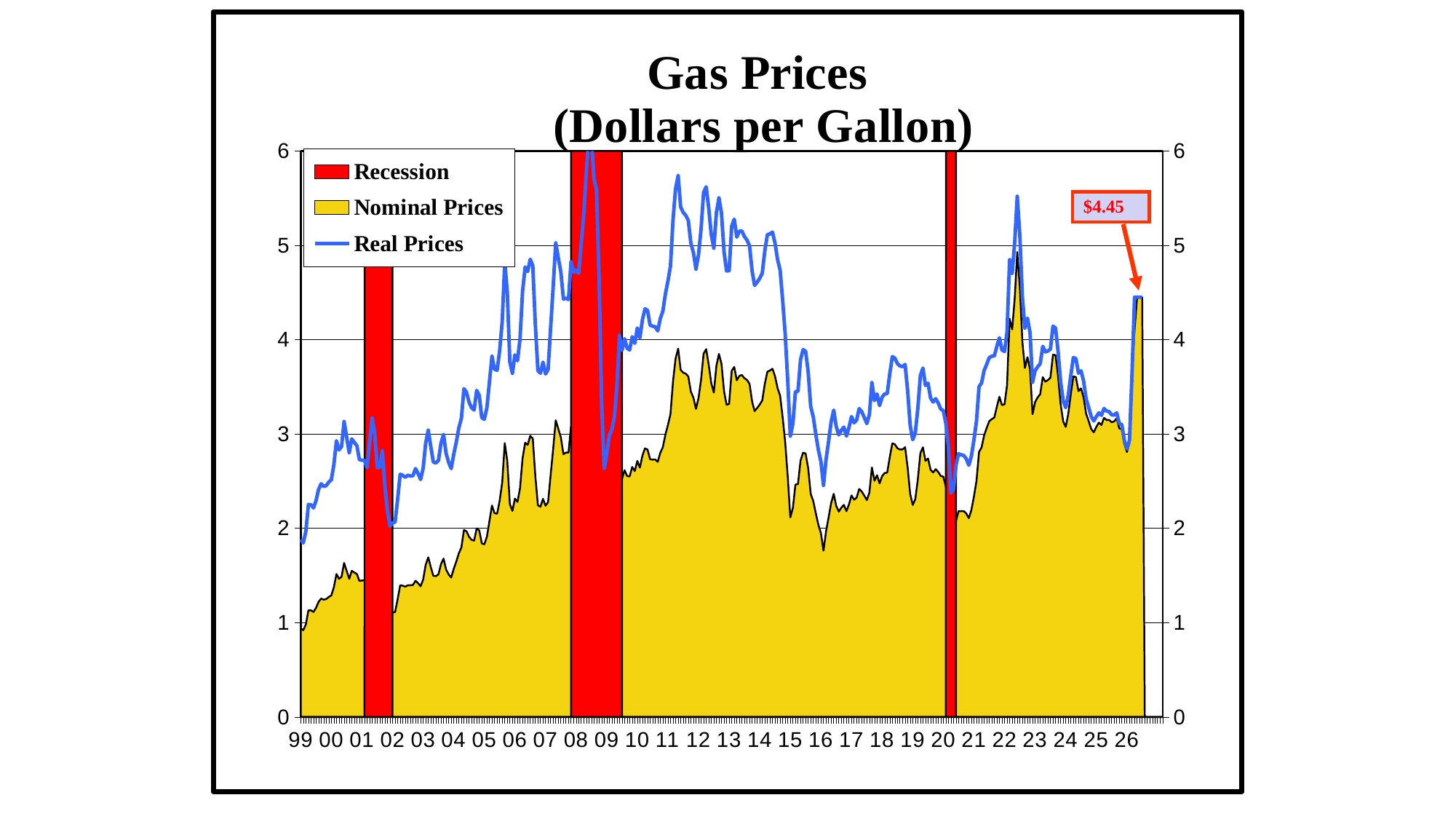
What colour is used for Recession in the legend? red How many entries does the chart legend list? 3 Is the peak of Nominal Prices around 2022 greater or less than 4? greater Is the peak of the Real Prices line around 2011 greater or less than 5? greater Do Nominal Prices generally rise or fall from 99 to 08? rise In which year does the Real Prices line reach its highest point? 08 In 2012, which is higher, Real Prices or Nominal Prices? Real Prices What is the title of the chart? Gas Prices (Dollars per Gallon) What value is printed in the callout label at the right end of the chart? $4.45 What kind of chart is this? area and line chart How many red Recession bands are shown on the chart? 3 Is the low point of Nominal Prices around 2016 greater or less than 2? less